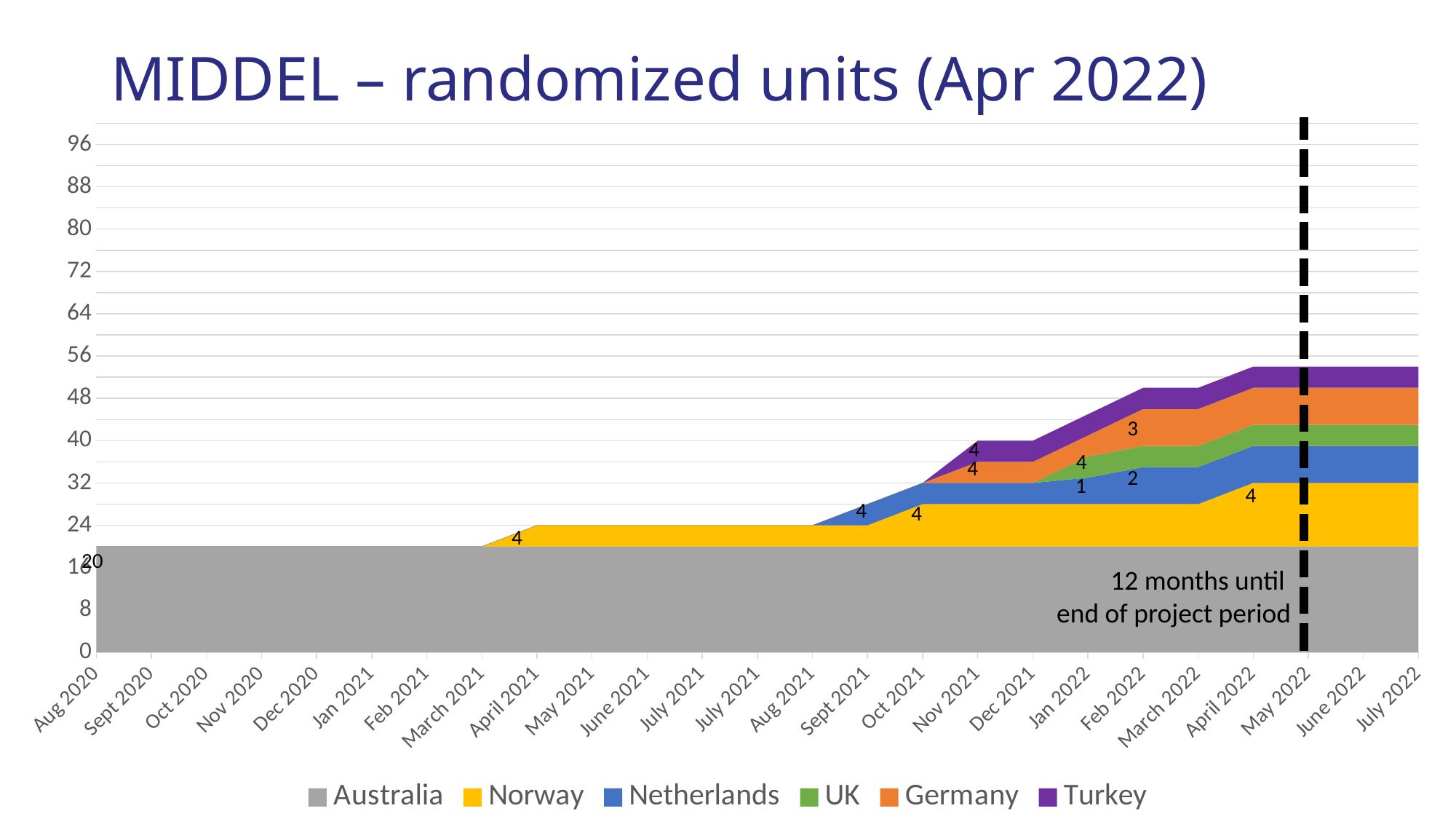
Is the total number of randomized units at July 2022 greater or less than 48? greater What kind of chart is shown on the slide? Stacked area chart What value is labelled for Australia at Aug 2020? 20 What is the title of the chart? MIDDEL – randomized units (Apr 2022) What does the annotation next to the dashed vertical line say? 12 months until end of project period What value is labelled for Netherlands at Feb 2022? 2 What value is labelled for Germany at Feb 2022? 3 Which country contributes the largest number of randomized units? Australia Does the total number of randomized units rise or fall from Aug 2020 to July 2022? rise What value is labelled for Norway at April 2022? 4 How many series does the legend list? 6 What value is labelled for Netherlands at Jan 2022? 1